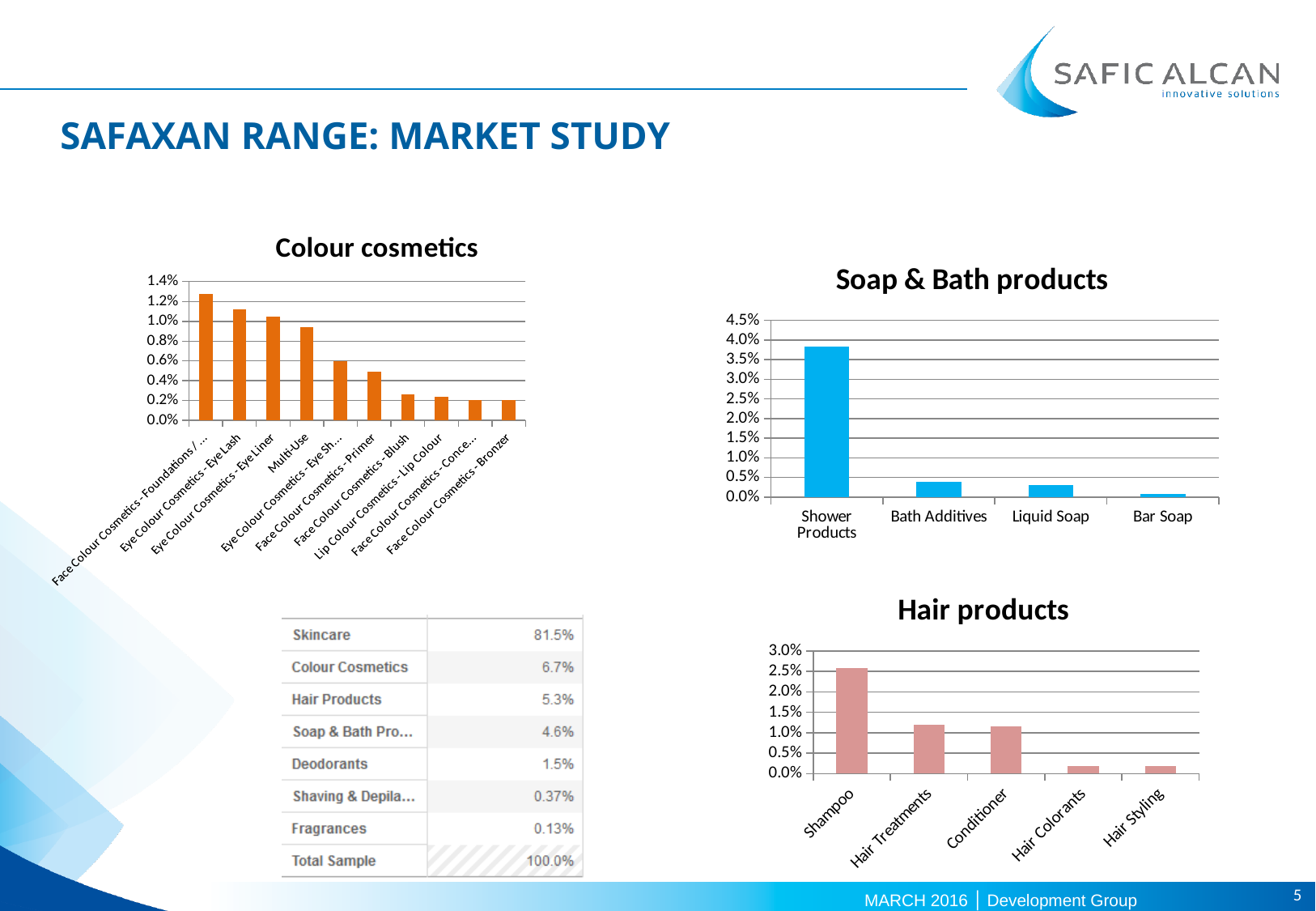
In the Soap & Bath products chart, which category has the highest value? Shower Products In the Hair products chart, which category has the highest value? Shampoo In the Hair products chart, which is larger: Shampoo or Conditioner? Shampoo In the Soap & Bath products chart, which category has the lowest value? Bar Soap How many categories are shown in the Hair products chart? 5 What kind of chart is the Colour cosmetics chart? bar chart In the Colour cosmetics chart, is the value for Multi-Use greater or less than 1.0%? less In the Soap & Bath products chart, is the value for Shower Products greater or less than 3.5%? greater In the Colour cosmetics chart, do the values rise or fall from left to right along the x axis? fall In the Hair products chart, is the value for Hair Colorants greater or less than 0.5%? less How many categories are shown in the Soap & Bath products chart? 4